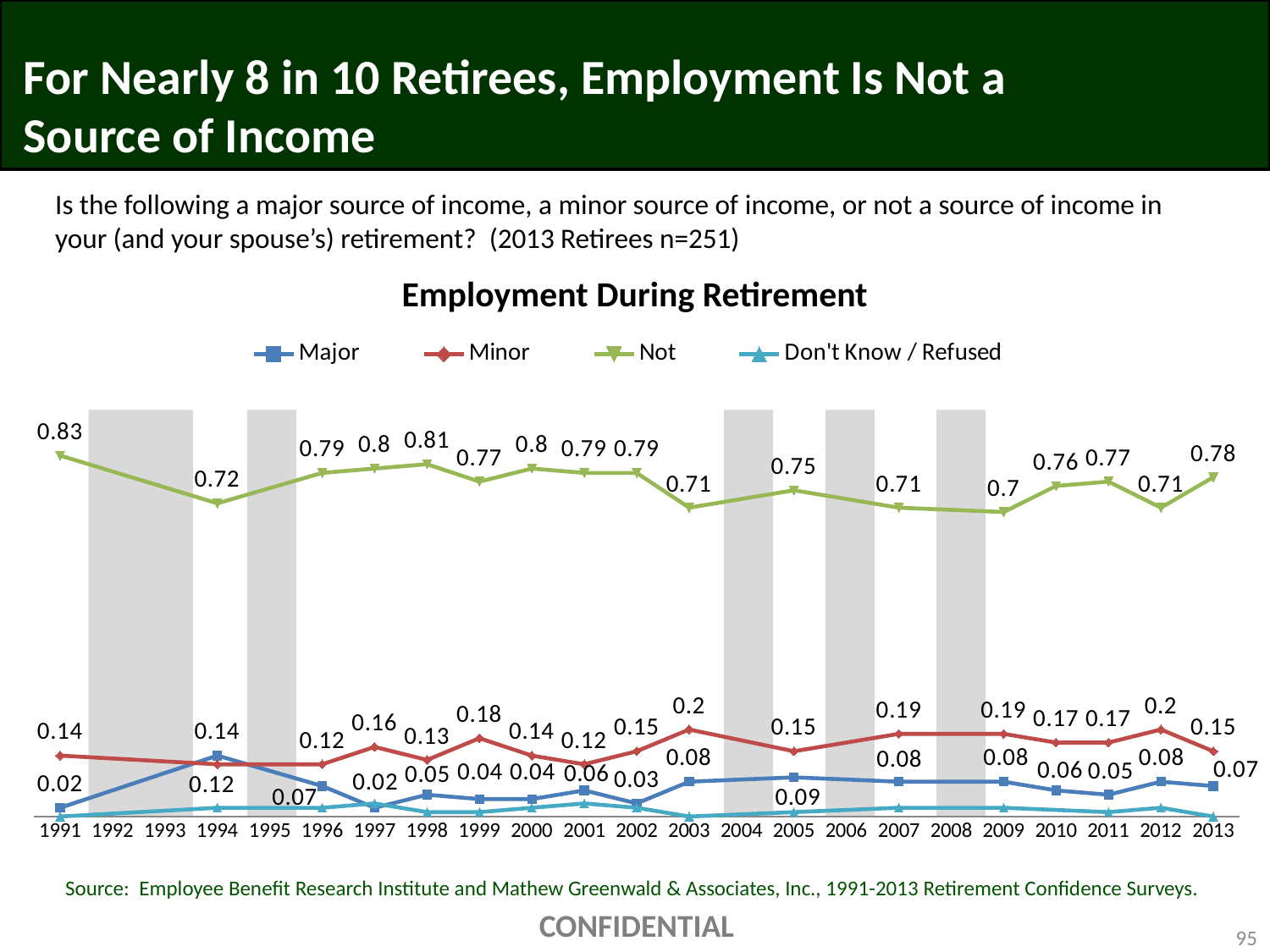
What is the value of the Minor series in 2003? 0.2 In which year does the Not series reach its lowest value? 2009 What is the value of the Major series in 2013? 0.07 What is the title of the chart? Employment During Retirement What is the value of the Not series in 1991? 0.83 In 2013, which series has the larger value, Not or Minor? Not In which year does the Not series reach its highest value? 1991 What is the value of the Minor series in 2013? 0.15 How many series does the legend list? 4 What is the difference between the Not series value in 1991 and in 2013? 0.05 What is the value of the Not series in 2013? 0.78 What kind of chart is shown on the slide? Line chart